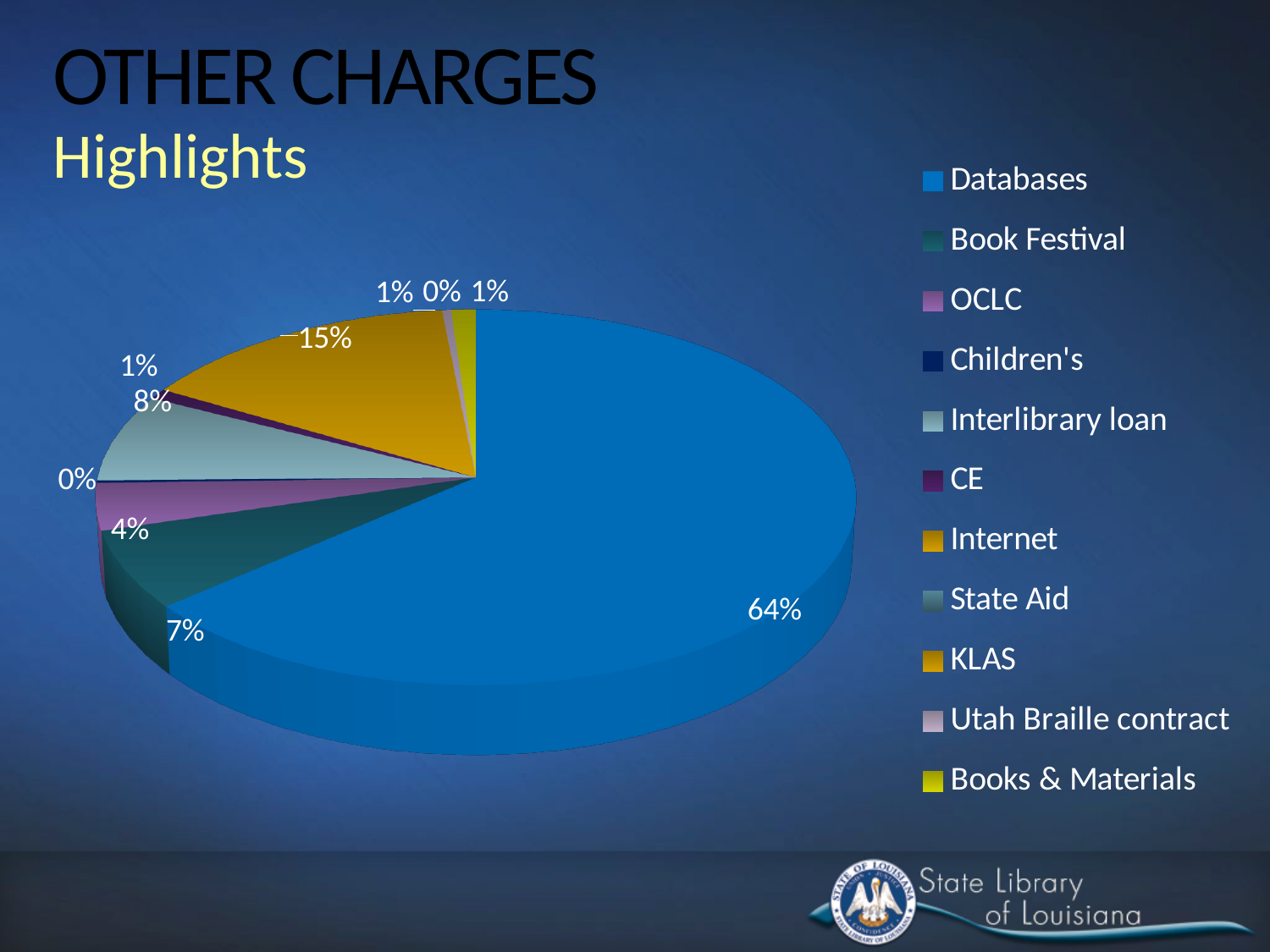
What percentage is shown for Internet? 15% What percentage is shown for Interlibrary loan? 8% How many categories does the legend list? 11 What share of the pie does Databases account for? 64% Which is larger, the share for Book Festival or the share for OCLC? Book Festival What kind of chart is shown on the slide? pie chart Which is larger, the share for Internet or the share for Interlibrary loan? Internet Which category has the largest slice of the pie? Databases What is the title shown at the top of the slide? OTHER CHARGES What percentage is shown for OCLC? 4% What percentage is shown for Book Festival? 7% What is the difference in percentage points between Databases and Internet? 49